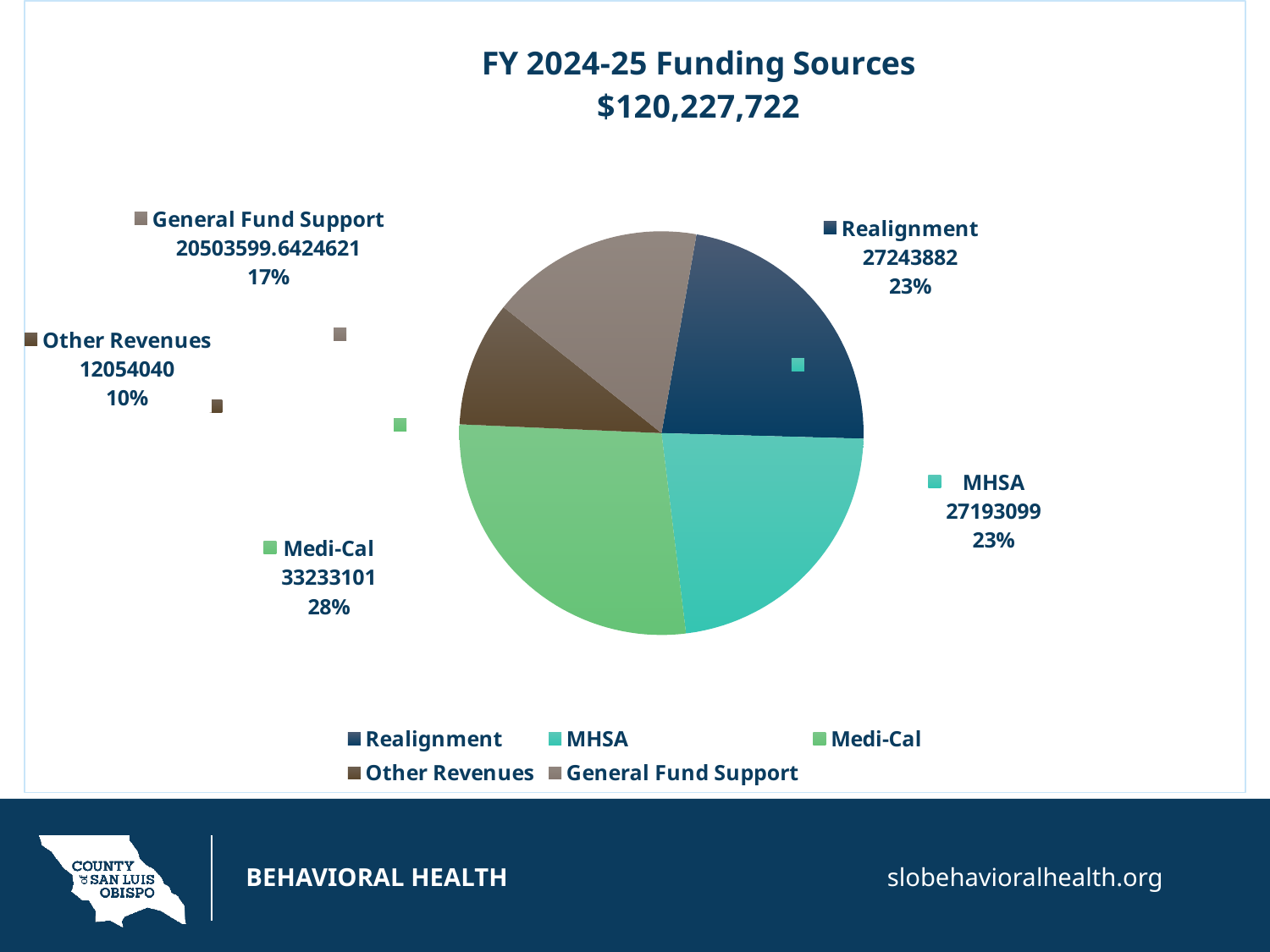
What is the title of the chart? FY 2024-25 Funding Sources $120,227,722 What is the value shown for Other Revenues? 12054040 Which funding source is the largest slice of the pie? Medi-Cal What is the value shown for Realignment? 27243882 What percentage share of the pie does MHSA represent? 23% What is the difference between the Medi-Cal value and the Realignment value? 5989219 What is the value shown for Medi-Cal? 33233101 What percentage share of the pie does General Fund Support represent? 17% Which funding source is the smallest slice of the pie? Other Revenues How many funding sources (slices) does the pie chart show? 5 Which is larger, Medi-Cal or Other Revenues? Medi-Cal What type of chart is shown on the slide? Pie chart